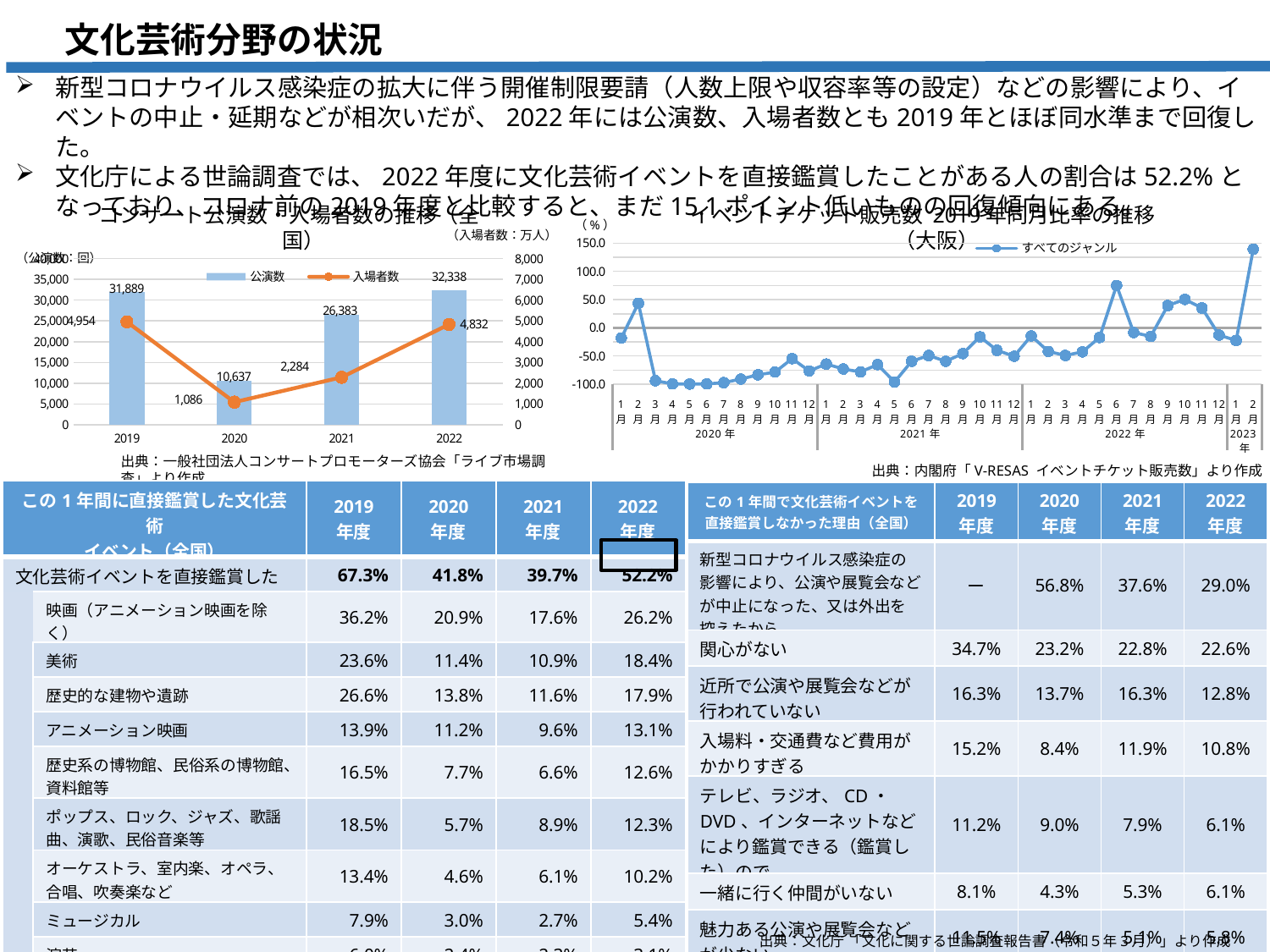
In the right chart (イベントチケット販売数 2019年同月比率の推移（大阪）), what kind of chart is it? line chart In the left chart (コンサート公演数・入場者数の推移（全国）), how many series does the legend list? 2 In the left chart (コンサート公演数・入場者数の推移（全国）), which year has the lowest 公演数? 2020 In the left chart (コンサート公演数・入場者数の推移（全国）), what is the difference in 公演数 between 2022 and 2021? 5,955 In the left chart (コンサート公演数・入場者数の推移（全国）), is 入場者数 larger in 2021 or in 2022? 2022 In the left chart (コンサート公演数・入場者数の推移（全国）), what is the value of 公演数 for 2022? 32,338 In the left chart (コンサート公演数・入場者数の推移（全国）), what is the value of 公演数 for 2019? 31,889 In the left chart (コンサート公演数・入場者数の推移（全国）), what is the value of 入場者数 for 2020? 1,086 In the right chart (イベントチケット販売数 2019年同月比率の推移（大阪）), what is the name of the series listed in the legend? すべてのジャンル In the left chart (コンサート公演数・入場者数の推移（全国）), which year has the highest 入場者数? 2019 In the right chart (イベントチケット販売数 2019年同月比率の推移（大阪）), is the value for 4月 2020年 greater or less than -50.0? less In the left chart (コンサート公演数・入場者数の推移（全国）), how many years are shown on the x axis? 4